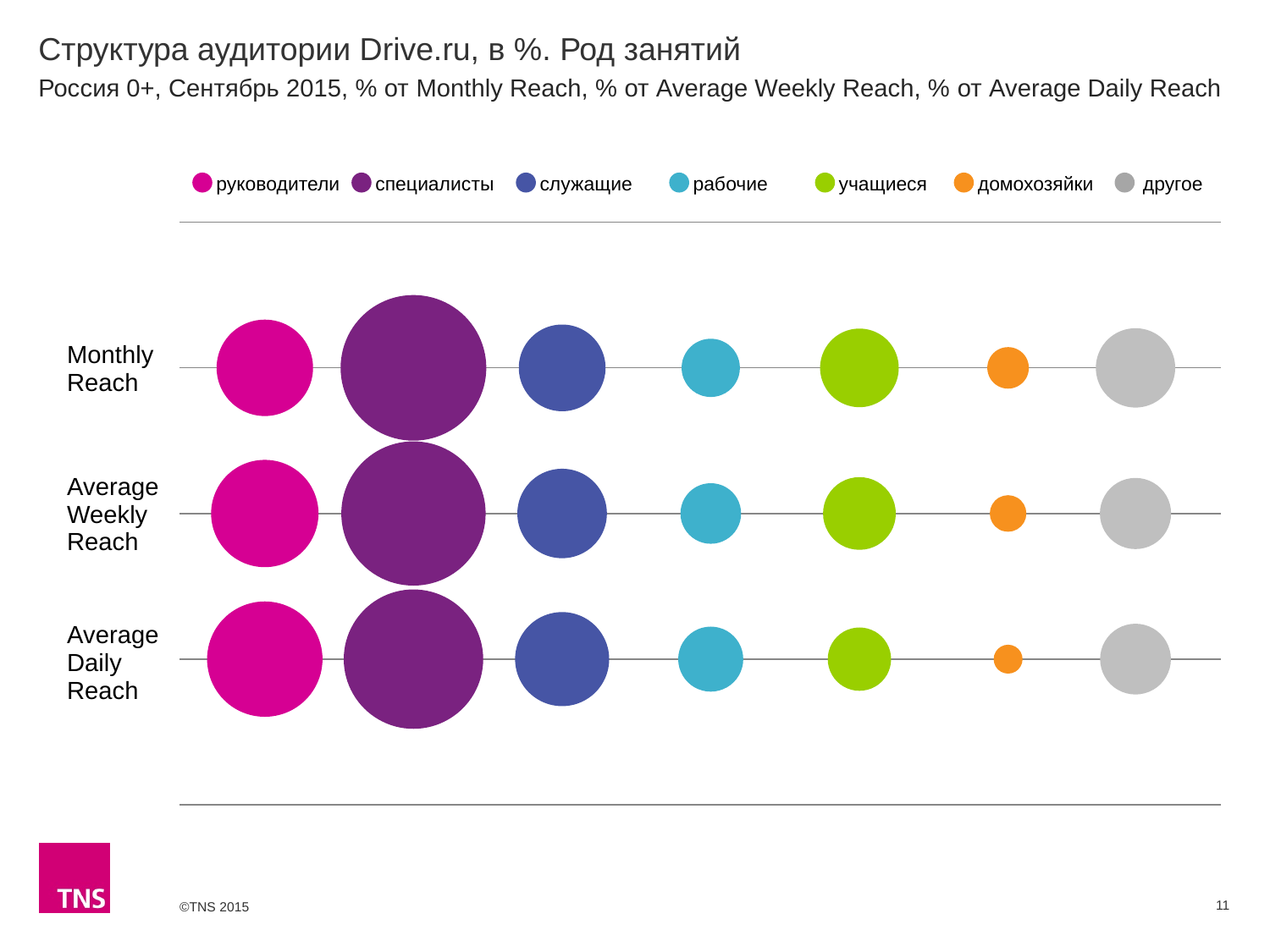
What is the title of the chart on the slide? Структура аудитории Drive.ru, в %. Род занятий In the Average Daily Reach row, which bubble is larger: другое or домохозяйки? другое Which occupation category has the largest bubble in the Monthly Reach row? специалисты Which occupation category has the smallest bubble in the Monthly Reach row? домохозяйки Which occupation category has the largest bubble in the Average Daily Reach row? специалисты What kind of chart is shown on the slide? bubble chart How many reach rows (Monthly, Weekly, Daily) are plotted on the chart? 3 In the Monthly Reach row, which bubble is larger: рабочие or учащиеся? учащиеся Which colour represents учащиеся in the legend? green In the Monthly Reach row, which bubble is larger: руководители or служащие? руководители How many occupation categories does the legend list? 7 Which occupation category has the smallest bubble in the Average Weekly Reach row? домохозяйки